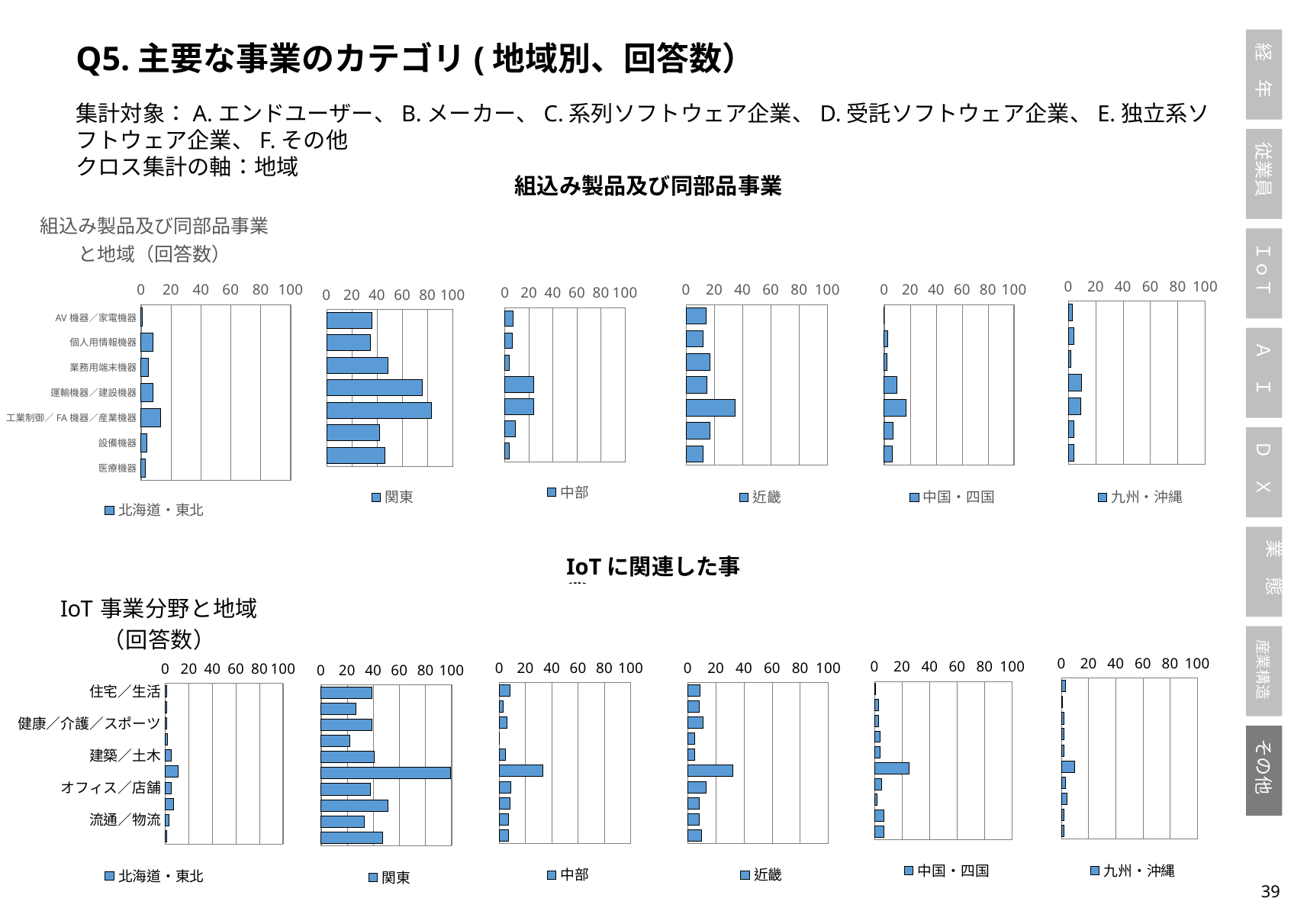
In the top-row 北海道・東北 chart (組込み製品及び同部品事業), how many categories are plotted? 7 In the top-row 関東 chart (組込み製品及び同部品事業), is the value for AV機器／家電機器 greater or less than 60? less In the top-row 関東 chart (組込み製品及び同部品事業), which category has the highest value? 工業制御／FA機器／産業機器 For 運輸機器／建設機器 in the top row (組込み製品及び同部品事業), which region has the larger value, 関東 or 中部? 関東 In the top-row 関東 chart (組込み製品及び同部品事業), is the value for 運輸機器／建設機器 greater or less than 60? greater In the top-row 北海道・東北 chart (組込み製品及び同部品事業), which category has the lowest value? AV機器／家電機器 In the top-row 中部 chart (組込み製品及び同部品事業), is the value for 工業制御／FA機器／産業機器 greater or less than 40? less What is the legend entry of the rightmost chart in the top row (組込み製品及び同部品事業)? 九州・沖縄 In the top-row 近畿 chart (組込み製品及び同部品事業), which category has the highest value? 工業制御／FA機器／産業機器 What kind of chart is used for the 関東 chart in the top row (組込み製品及び同部品事業)? bar chart